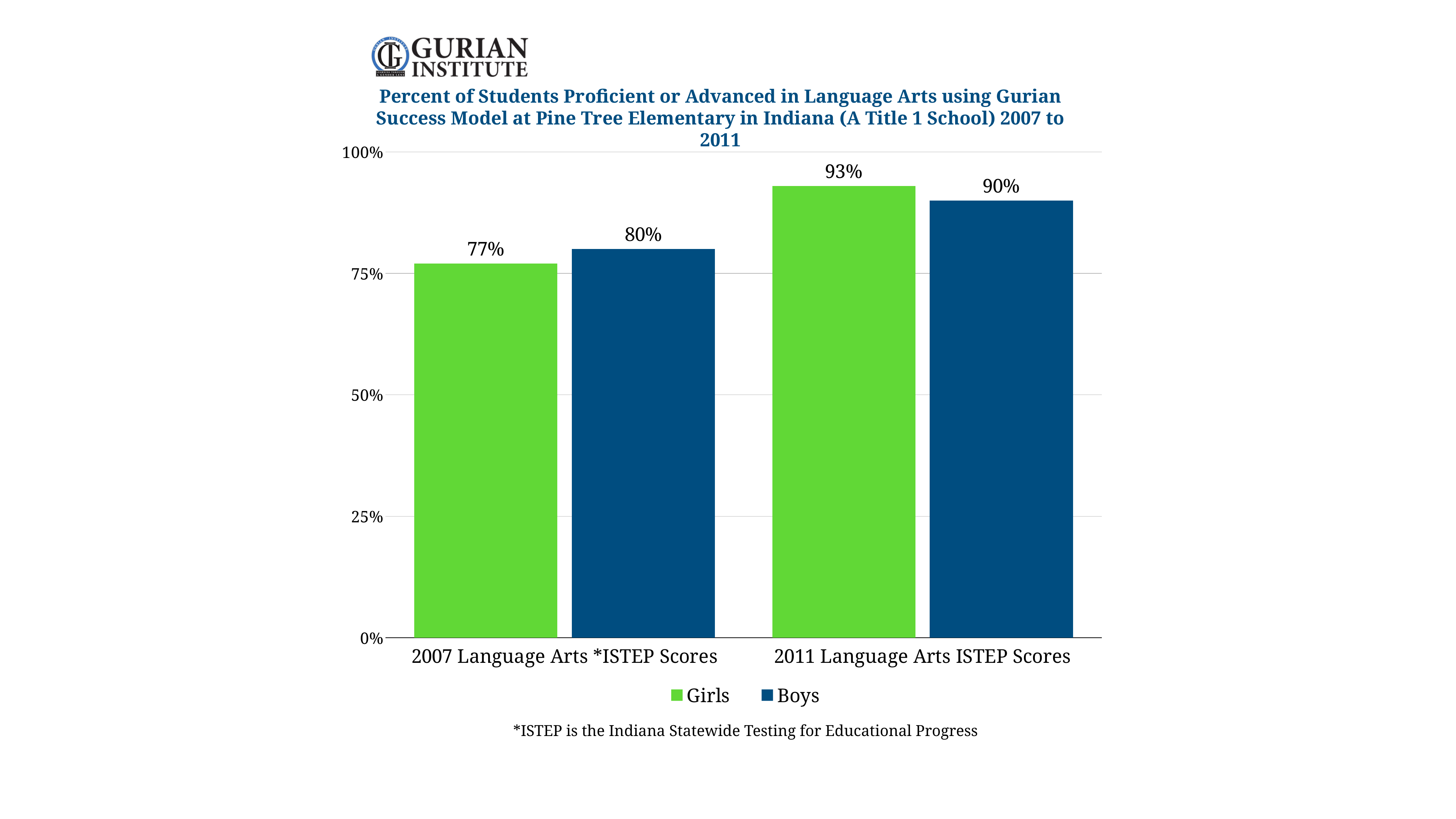
By how many percentage points did the Girls value increase from 2007 to 2011? 16 Is the value for Boys in 2011 greater or less than 75%? greater Which bar has the lowest value on the chart? Girls, 2007 Language Arts ISTEP Scores What percent of girls were proficient or advanced in the 2007 Language Arts ISTEP Scores? 77% What is the value for Boys in the 2007 Language Arts ISTEP Scores? 80% What percent of boys were proficient or advanced in the 2011 Language Arts ISTEP Scores? 90% How many series does the legend list? 2 In 2007, which group had the higher value, Girls or Boys? Boys Which bar has the highest value on the chart? Girls, 2011 Language Arts ISTEP Scores What kind of chart is shown on the slide? Bar chart Which colour represents Girls in the chart? Green What is the difference between the Boys and Girls values in the 2011 Language Arts ISTEP Scores? 3